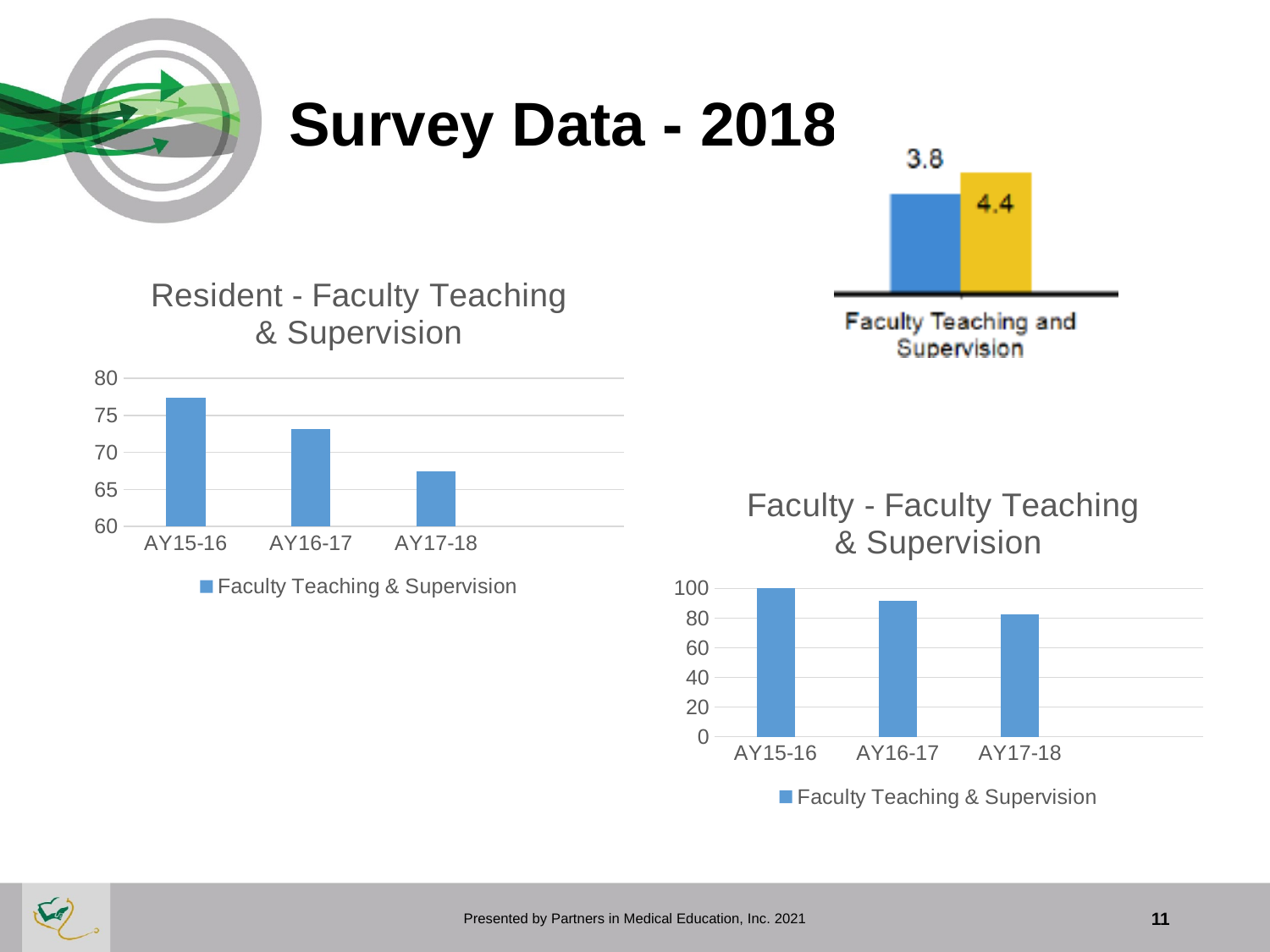
In the Resident - Faculty Teaching & Supervision chart, do the values rise or fall from AY15-16 to AY17-18? fall How many academic years are shown in the Faculty - Faculty Teaching & Supervision chart? 3 In the Faculty - Faculty Teaching & Supervision chart, is the value for AY16-17 greater or less than 80? greater In the Resident - Faculty Teaching & Supervision chart, is the value for AY15-16 greater or less than 75? greater In the Faculty - Faculty Teaching & Supervision chart, which academic year has the lowest value? AY17-18 In the small Faculty Teaching and Supervision chart at the top right, what is the difference between the two labelled values? 0.6 What kind of chart is the Faculty - Faculty Teaching & Supervision chart? bar chart In the Resident - Faculty Teaching & Supervision chart, which academic year has the highest value? AY15-16 How many series does the legend of the Resident - Faculty Teaching & Supervision chart list? 1 In the Faculty - Faculty Teaching & Supervision chart, which is larger, the value for AY15-16 or AY17-18? AY15-16 In the Resident - Faculty Teaching & Supervision chart, which academic year has the lowest value? AY17-18 In the Resident - Faculty Teaching & Supervision chart, is the value for AY17-18 greater or less than 70? less